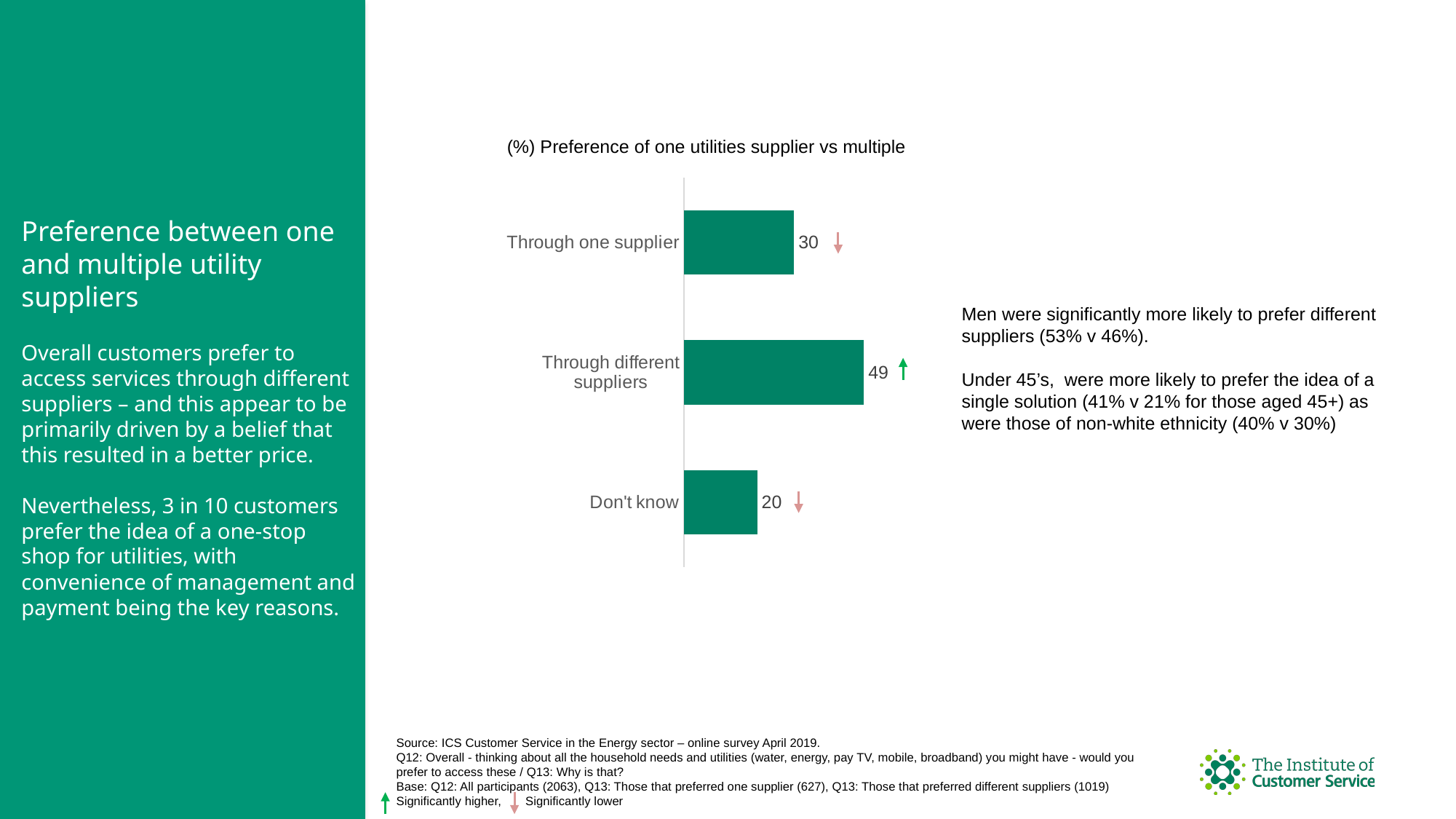
Which category is marked with a green upward arrow indicating 'significantly higher'? Through different suppliers What is the title of the chart? (%) Preference of one utilities supplier vs multiple What is the difference between the values for 'Through different suppliers' and 'Through one supplier'? 19 Which category has the highest value? Through different suppliers Which is larger, the value for 'Through one supplier' or the value for 'Don't know'? Through one supplier What kind of chart is shown on the slide? Bar chart Which category has the lowest value? Don't know What is the value for 'Don't know'? 20 What is the value for 'Through different suppliers'? 49 What is the value for 'Through one supplier'? 30 What is the difference between the values for 'Through one supplier' and 'Don't know'? 10 How many categories are shown in the chart? 3